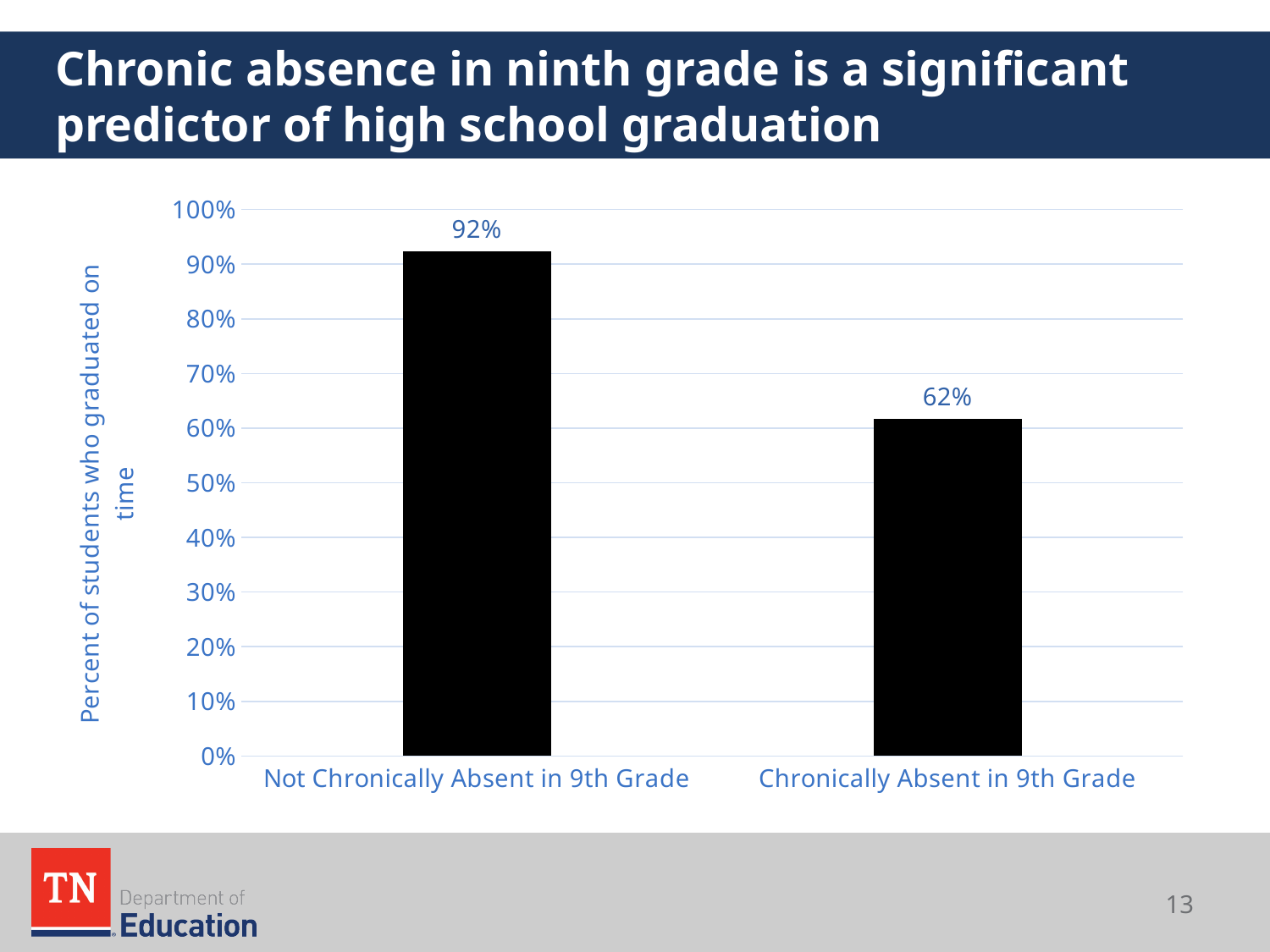
Is the on-time graduation rate for students chronically absent in 9th grade greater or less than 70%? less Which category has the higher on-time graduation rate? Not Chronically Absent in 9th Grade What percent of students who were chronically absent in 9th grade graduated on time? 62% Is the on-time graduation rate for students not chronically absent in 9th grade greater or less than 90%? greater What is the maximum value shown on the vertical axis of the chart? 100% What kind of chart is shown on the slide? Bar chart How many categories are shown on the x axis of the chart? 2 Which category has the lower on-time graduation rate? Chronically Absent in 9th Grade What percent of students who were not chronically absent in 9th grade graduated on time? 92% What is the label of the vertical axis of the chart? Percent of students who graduated on time What is the difference in on-time graduation rate between students not chronically absent and students chronically absent in 9th grade? 30%